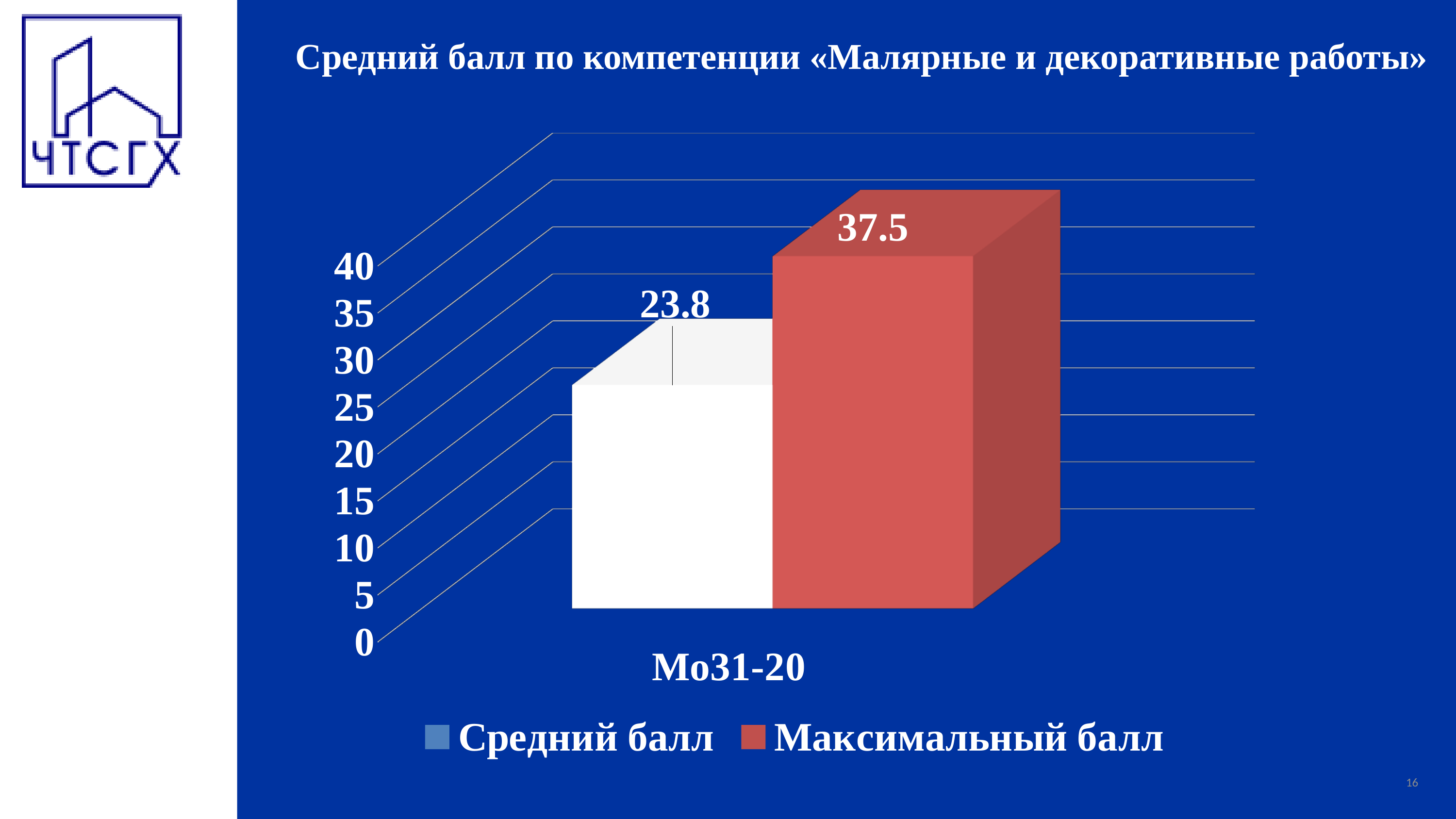
How many categories are shown on the x axis? 1 What is the label of the category on the x axis? Мо31-20 How many series does the legend list? 2 What is the difference between Максимальный балл and Средний балл for Мо31-20? 13.7 What is the value of Средний балл for Мо31-20? 23.8 What is the value of Максимальный балл for Мо31-20? 37.5 What is the title of the chart? Средний балл по компетенции «Малярные и декоративные работы» What is the highest value shown on the vertical axis? 40 What kind of chart is shown on the slide? bar chart Which series has the higher value for Мо31-20, Средний балл or Максимальный балл? Максимальный балл Is the value of Максимальный балл for Мо31-20 greater or less than 35? greater Is the value of Средний балл for Мо31-20 greater or less than 25? less